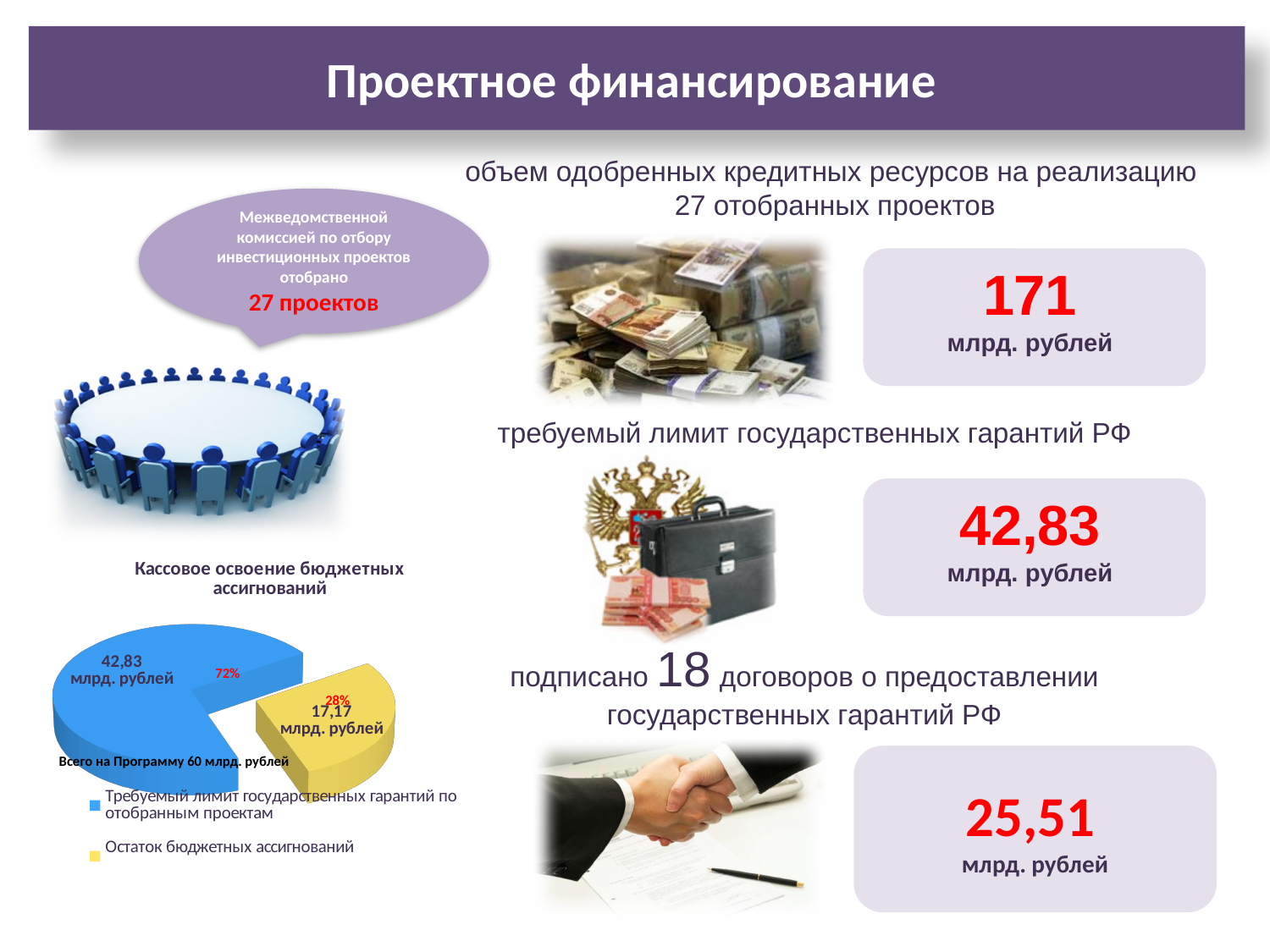
What kind of chart is shown under the title "Кассовое освоение бюджетных ассигнований"? pie chart Which slice of the pie chart is the smallest? Остаток бюджетных ассигнований In the pie chart, what is the difference between the value for "Требуемый лимит государственных гарантий по отобранным проектам" and the value for "Остаток бюджетных ассигнований"? 25,66 млрд. рублей How many entries does the legend of the pie chart list? 2 Which colour represents "Остаток бюджетных ассигнований" in the pie chart? yellow How many slices does the pie chart have? 2 In the pie chart, what is the value for "Остаток бюджетных ассигнований"? 17,17 млрд. рублей What is the title of the pie chart on the slide? Кассовое освоение бюджетных ассигнований Which slice of the pie chart is the largest? Требуемый лимит государственных гарантий по отобранным проектам What share of the pie does "Требуемый лимит государственных гарантий по отобранным проектам" take? 72% What share of the pie does "Остаток бюджетных ассигнований" take? 28% In the pie chart, what is the value for "Требуемый лимит государственных гарантий по отобранным проектам"? 42,83 млрд. рублей